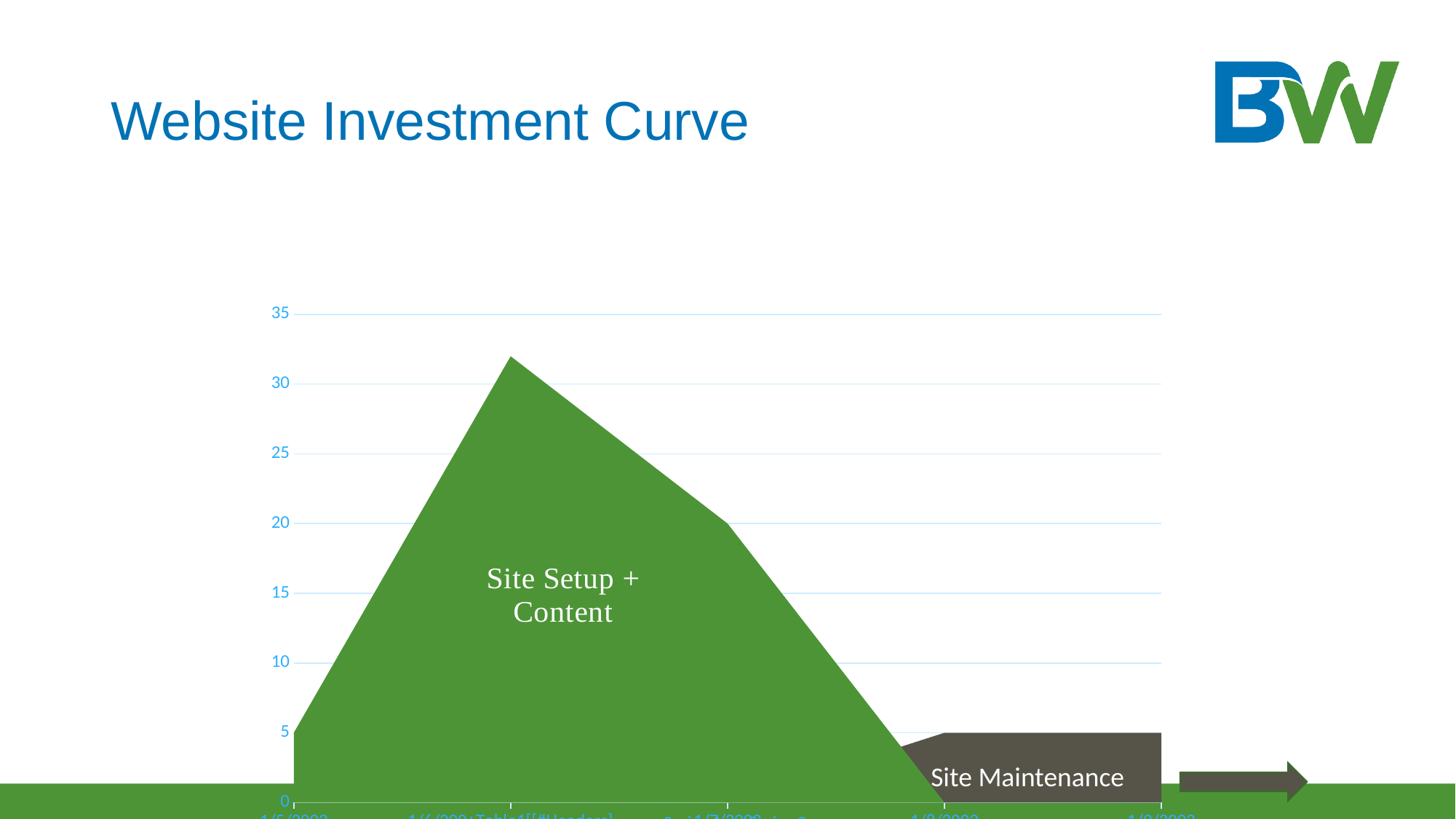
What is the value of the Site Setup + Content area at its first (leftmost) point? 5 Is the peak value of the Site Setup + Content area greater or less than 30? greater Is the value of the Site Setup + Content area at its third point greater or less than 25? less What are the two labelled areas in the chart? Site Setup + Content and Site Maintenance Is the peak value of the Site Setup + Content area greater or less than 35? less After its peak, does the Site Setup + Content area rise or fall along the x axis? fall Does the Site Setup + Content area rise or fall between its first point and its peak? rise What is the highest value shown on the vertical axis? 35 Which area reaches a higher value, Site Setup + Content or Site Maintenance? Site Setup + Content What is the title of the chart on the slide? Website Investment Curve What kind of chart is shown on the slide? area chart